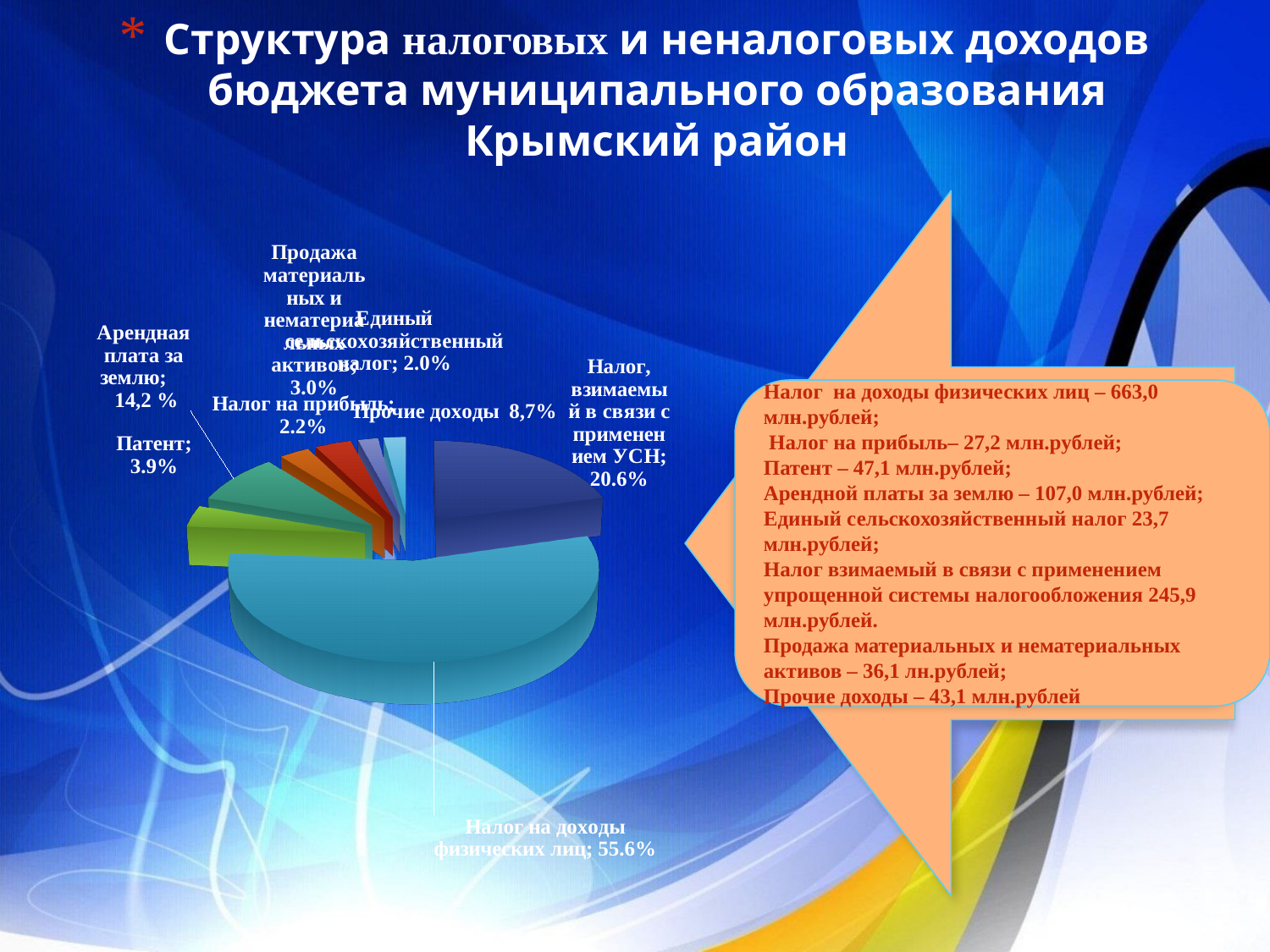
What share of the pie is Налог на доходы физических лиц? 55.6% How many slices does the pie chart have? 8 Which category has the smallest share of the pie? Единый сельскохозяйственный налог What kind of chart is shown on the slide? Pie chart What is the value shown for Продажа материальных и нематериальных активов? 3.0% What is the difference in percentage points between Налог на доходы физических лиц and Налог, взимаемый в связи с применением УСН? 35.0% Which is larger, the share for Патент or the share for Налог на прибыль? Патент What is the value shown for Арендная плата за землю? 14,2 % What is the value shown for Налог, взимаемый в связи с применением УСН? 20.6% What is the value shown for Патент? 3.9% Which category has the largest share of the pie? Налог на доходы физических лиц What is the value shown for Прочие доходы? 8,7%